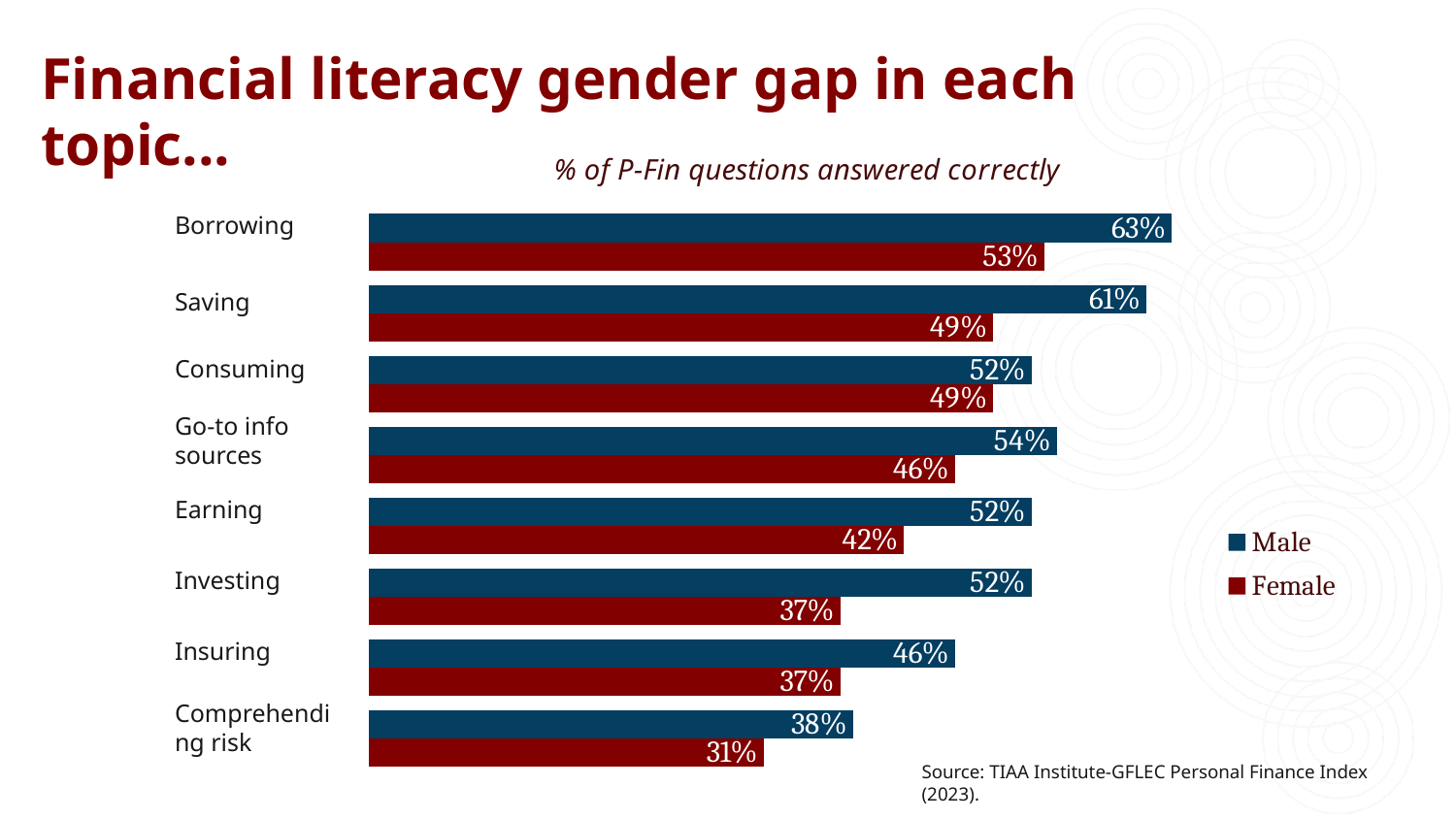
Which is larger, the Female value for Borrowing or the Female value for Earning? Female value for Borrowing Which topic has the lowest Female value? Comprehending risk How many topics are shown on the chart? 8 What is the difference between the Male and Female values for Investing? 15% How many series does the legend list? 2 What kind of chart is shown on the slide? Bar chart What is the difference between the Male and Female values for Consuming? 3% What is the Female value for Investing? 37% What percentage of Borrowing questions did males answer correctly? 63% What is the subtitle of the chart? % of P-Fin questions answered correctly What is the Male value for Comprehending risk? 38% Which topic has the highest Male value? Borrowing